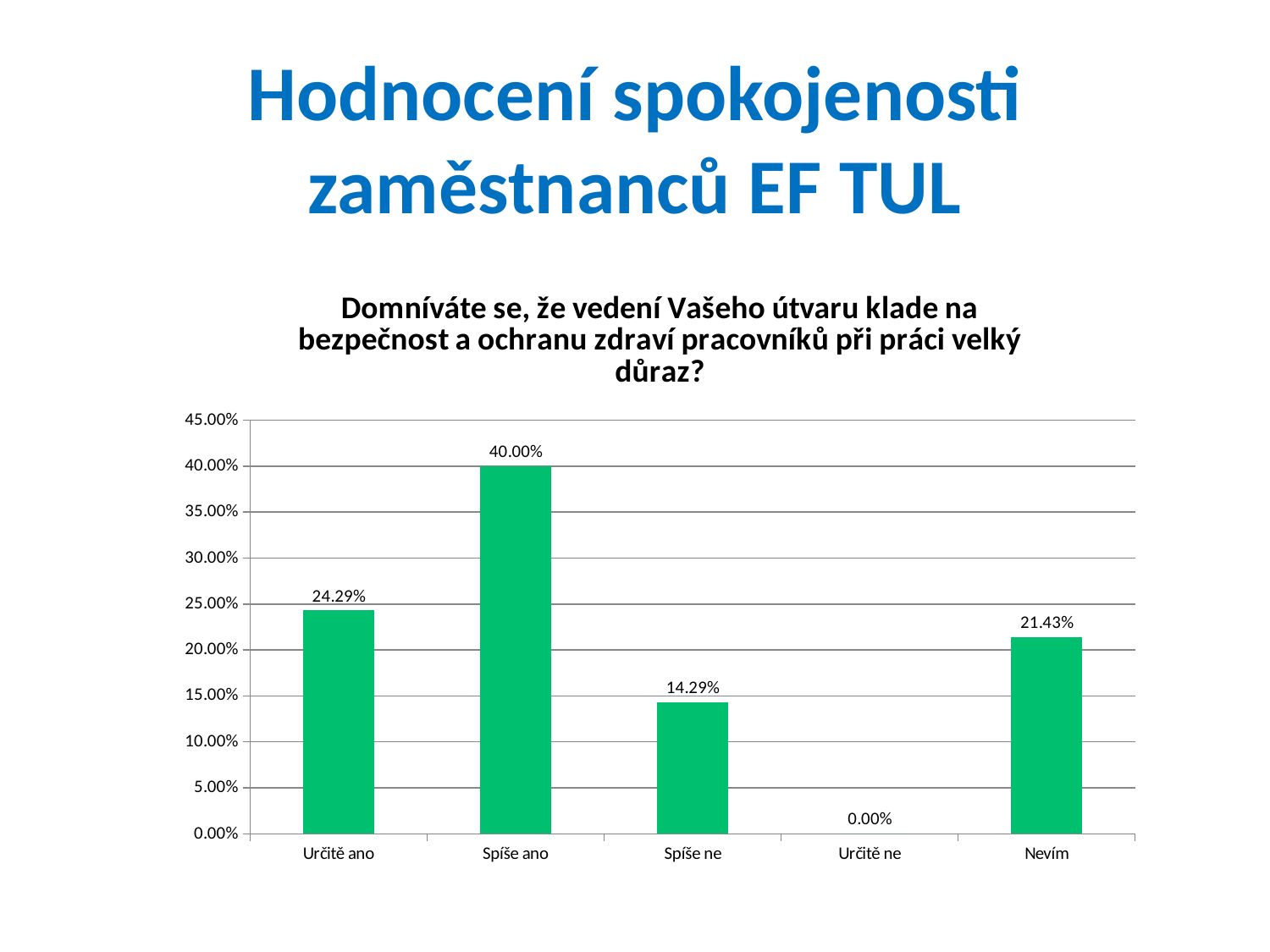
Which category has the lowest value? Určitě ne What kind of chart is shown on the slide? Bar chart What colour are the bars in the chart? Green What is the value for "Určitě ano"? 24.29% Which is larger, the value for "Spíše ne" or the value for "Nevím"? Nevím Which category has the highest value? Spíše ano What is the value for "Určitě ne"? 0.00% What is the value for "Spíše ano"? 40.00% What is the difference between the values for "Určitě ano" and "Nevím"? 2.86% How many categories are shown on the x axis? 5 What is the value for "Nevím"? 21.43% What is the difference between the values for "Spíše ano" and "Spíše ne"? 25.71%